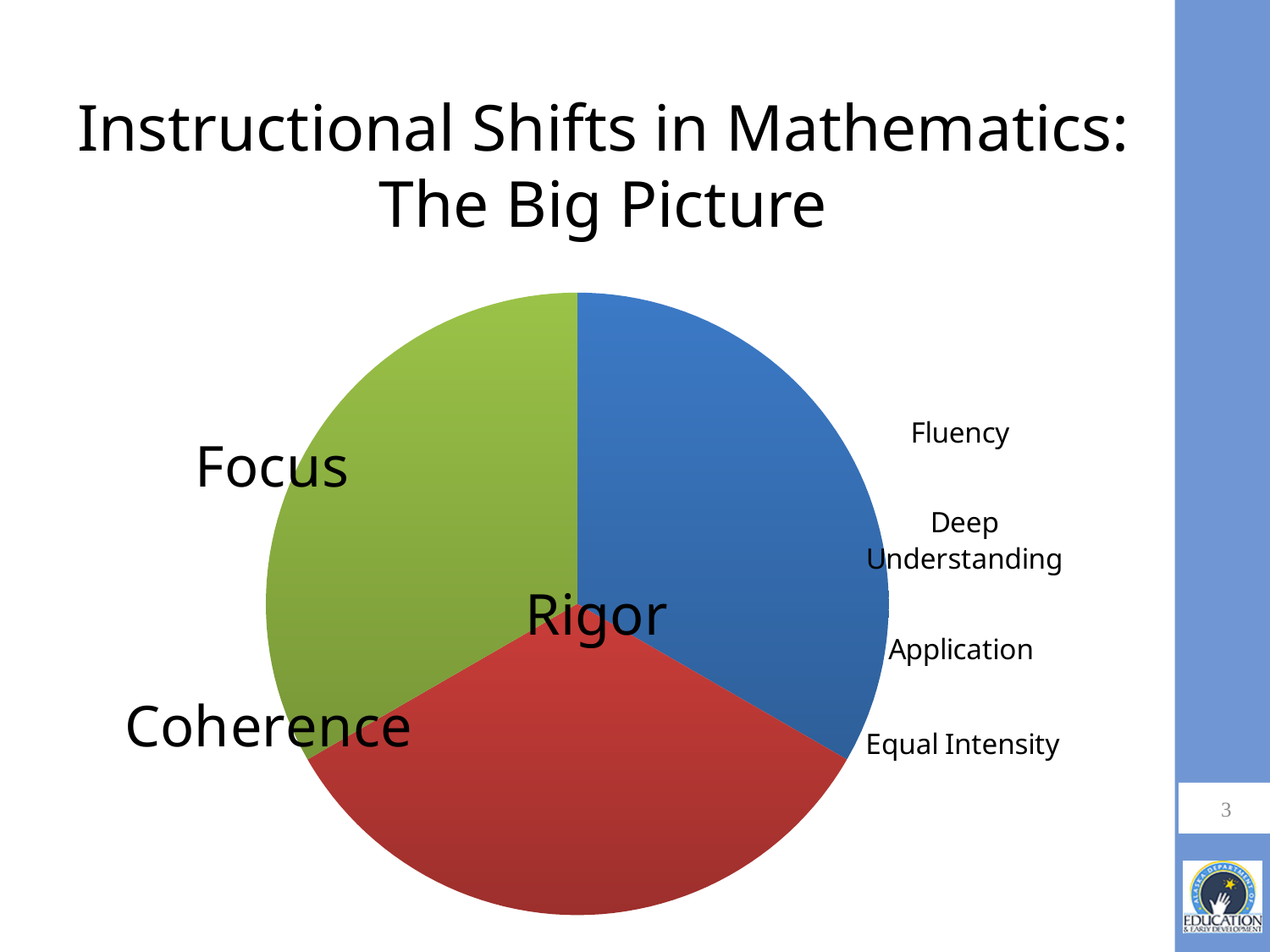
What is the title of the slide containing the pie chart? Instructional Shifts in Mathematics: The Big Picture What kind of chart is shown on the slide? pie chart Are the three slices of the pie chart roughly equal in size? yes What colour is the Focus slice of the pie chart? green Which slice of the pie chart is labelled in the lower-left area? Coherence What are the three slices of the pie chart labelled? Focus, Coherence, Rigor How many slices does the pie chart have? 3